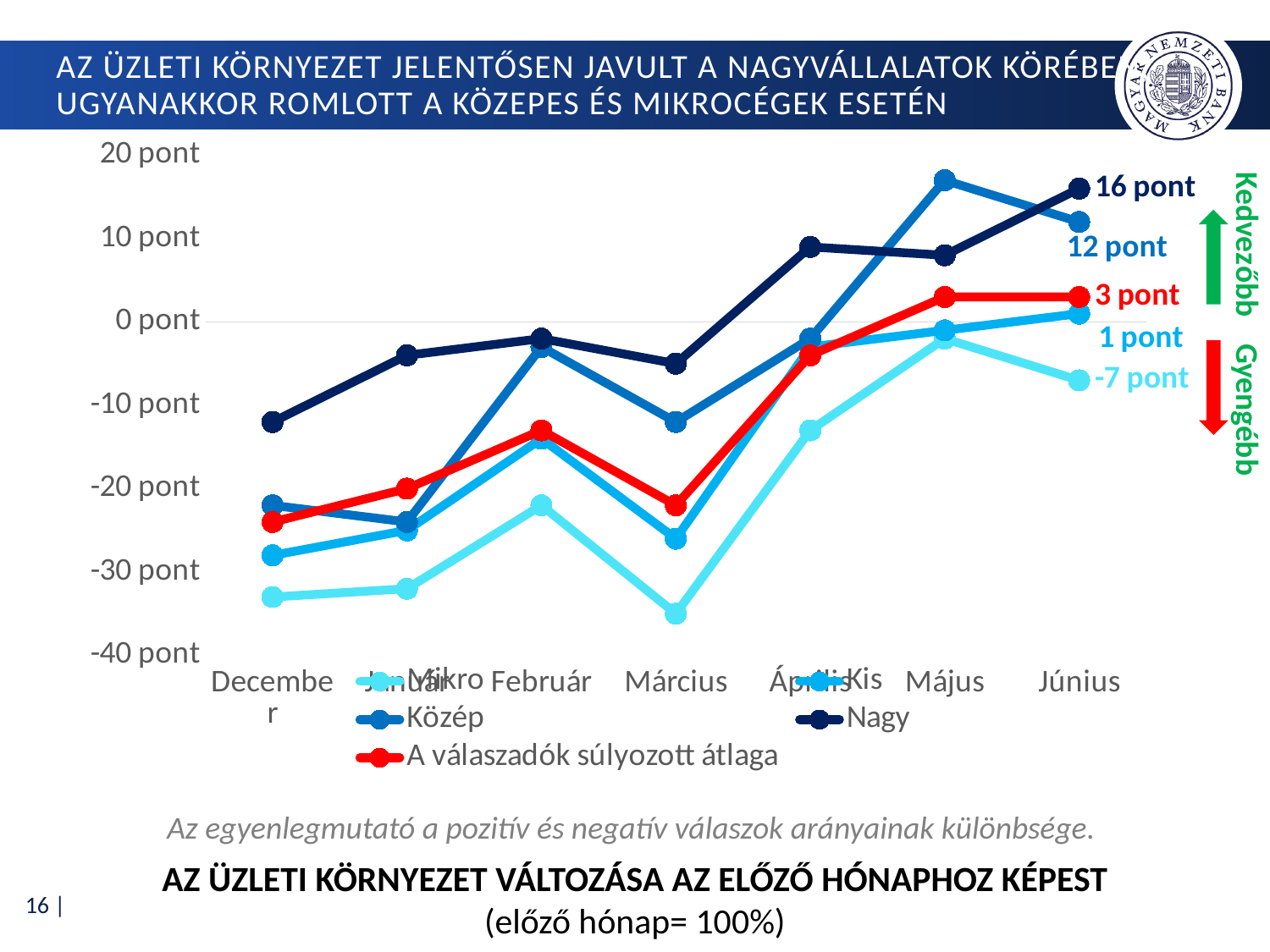
What is the value for Közép in Június? 12 pont How many months are shown along the x axis? 7 What kind of chart is shown on the slide? line chart Which is larger in Május, the value for Közép or the value for Nagy? Közép Which series has the lowest value in Június? Mikro Which series has the highest value in Június? Nagy How many series does the legend list? 5 What is the value for A válaszadók súlyozott átlaga in Június? 3 pont What is the difference between the Nagy and Közép values in Június? 4 pont What is the value for Mikro in Június? -7 pont What is the value for Nagy in Június? 16 pont Is the value for Mikro in December greater or less than -30 pont? less